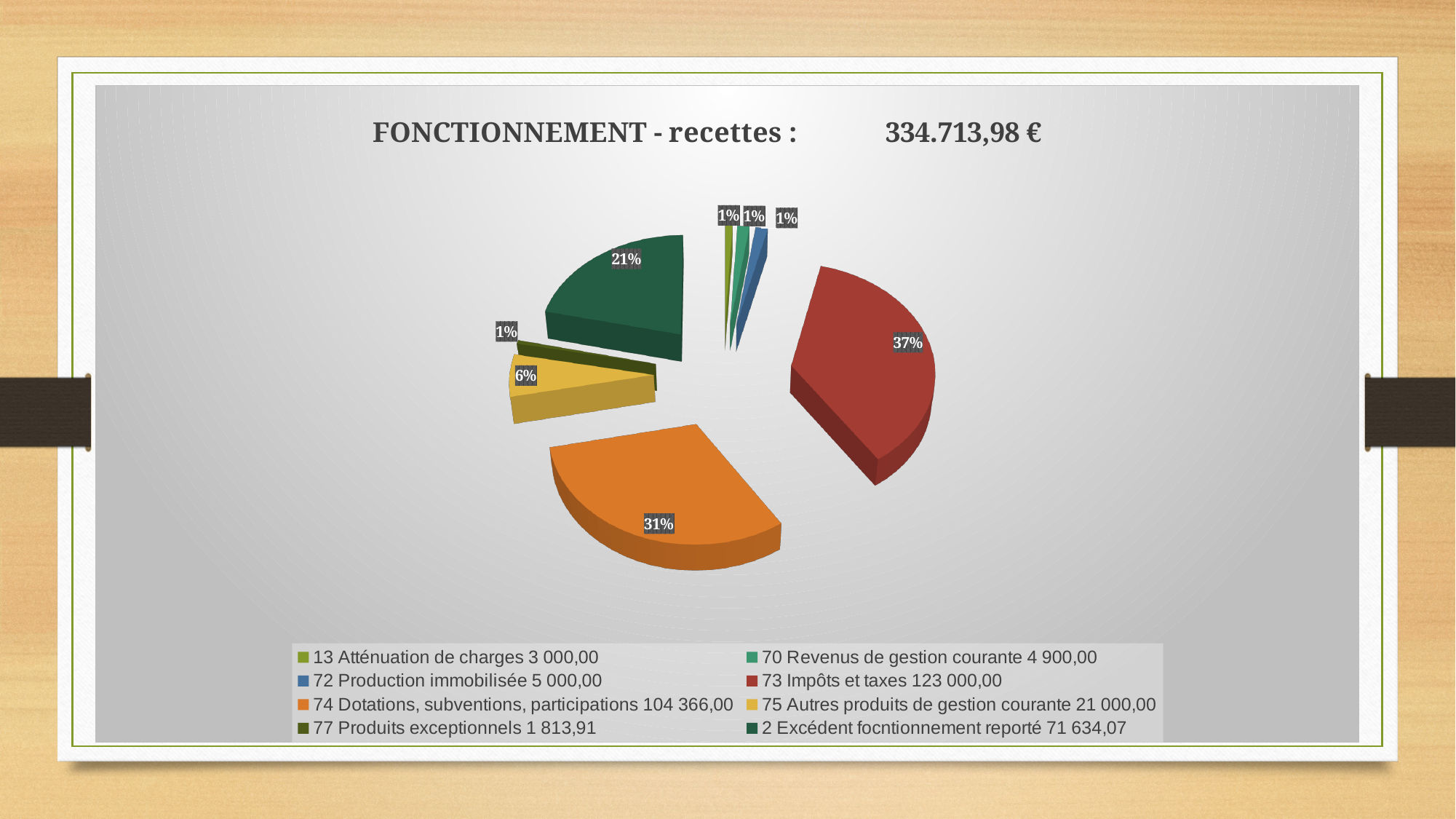
What share of the pie does "2 Excédent focntionnement reporté" represent? 21% What kind of chart is shown on the slide? pie chart Which category has the largest slice of the pie? 73 Impôts et taxes What amount is shown in the legend for "77 Produits exceptionnels"? 1 813,91 What share of the pie does "73 Impôts et taxes" represent? 37% What share of the pie does "74 Dotations, subventions, participations" represent? 31% Which slice is larger: "74 Dotations, subventions, participations" or "2 Excédent focntionnement reporté"? 74 Dotations, subventions, participations What amount is shown in the legend for "73 Impôts et taxes"? 123 000,00 What is the difference in percentage points between the "73 Impôts et taxes" slice and the "74 Dotations, subventions, participations" slice? 6 percentage points How many slices does the pie chart have? 8 What total amount is shown in the chart title? 334.713,98 €